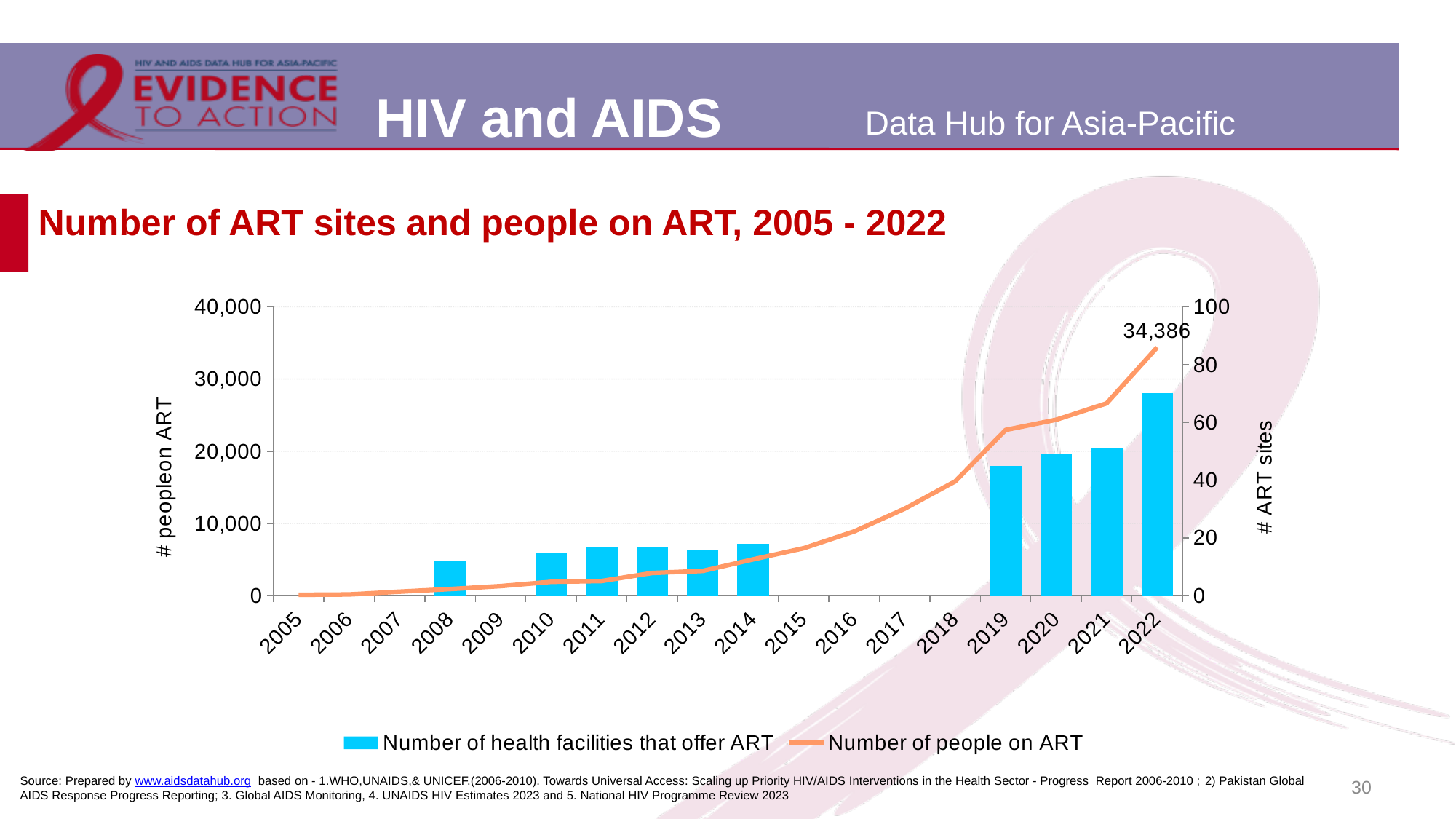
What kind of chart is this? Combination bar and line chart Does the number of people on ART rise or fall from 2005 to 2022? Rise What is the number of people on ART in 2022, as labelled on the chart? 34,386 Which series is shown as a line? Number of people on ART Is the number of people on ART in 2021 greater or less than 20,000? greater Which year has the highest number of health facilities that offer ART? 2022 How many series does the legend list? 2 What is the title of the chart? Number of ART sites and people on ART, 2005 - 2022 Which year has more health facilities that offer ART, 2019 or 2022? 2022 Is the number of health facilities that offer ART in 2022 greater or less than 60? greater How many years are shown on the x axis? 18